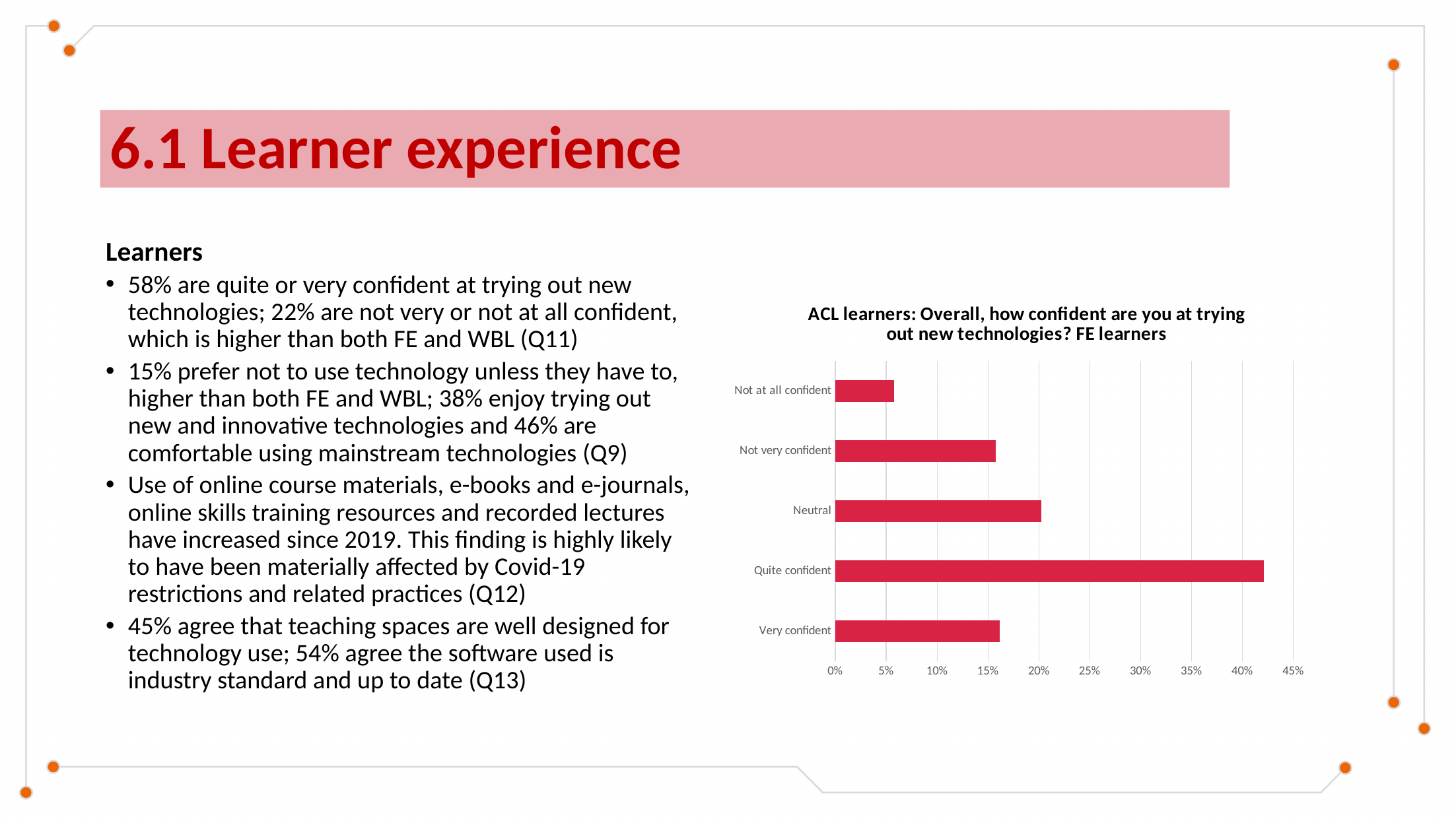
What kind of chart is shown on the slide? bar chart What is the title of the chart? ACL learners: Overall, how confident are you at trying out new technologies? FE learners Is the value for Not at all confident greater or less than 10%? less How many categories are shown on the chart? 5 Is the value for Quite confident greater or less than 40%? greater Is the value for Neutral greater or less than 25%? less Which category has the highest value? Quite confident Which is larger, the value for Neutral or the value for Not at all confident? Neutral Which category has the lowest value? Not at all confident